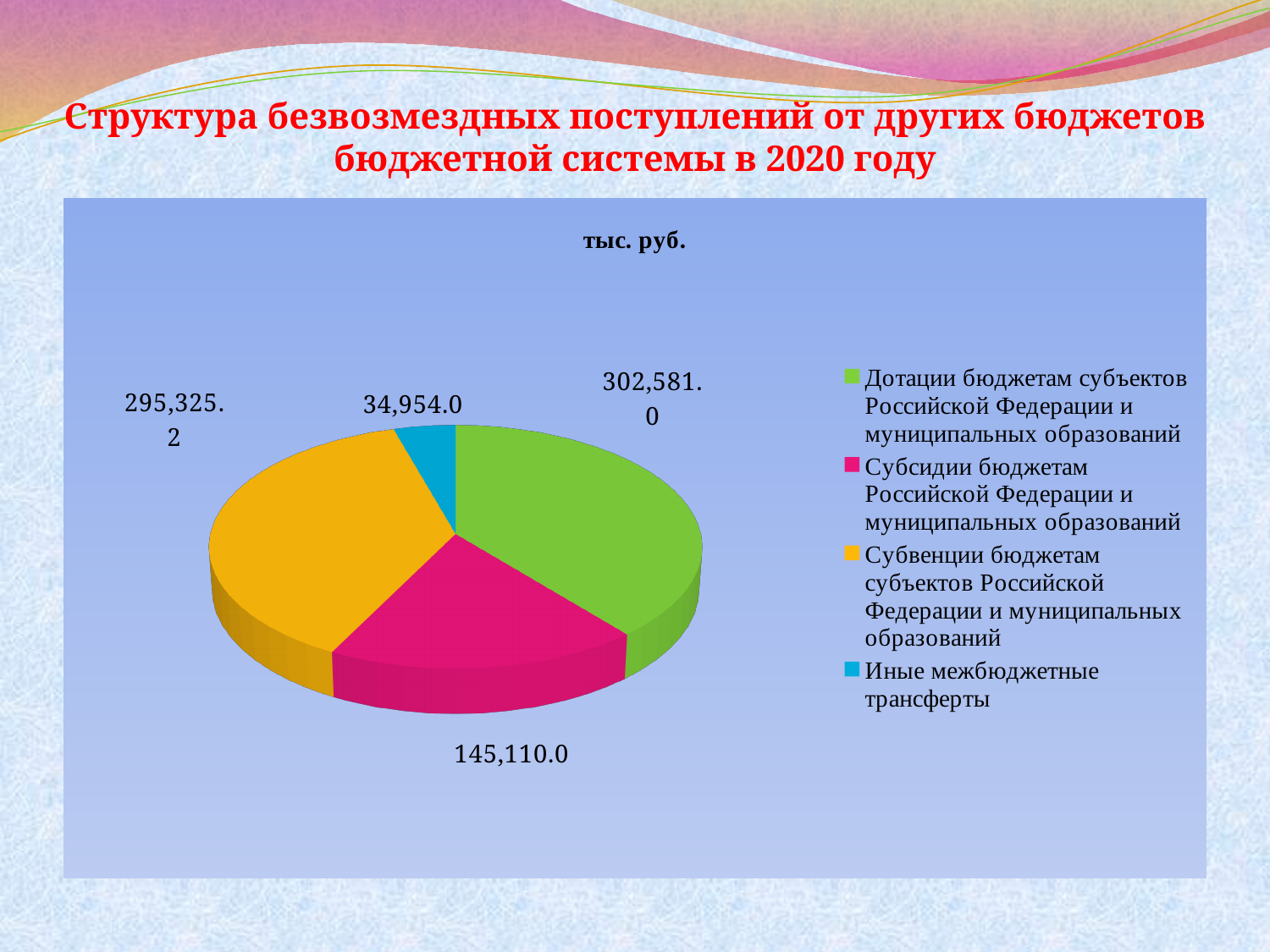
How many slices does the pie chart have? 4 What is the difference between the values for Дотации and Субвенции? 7,255.8 What is the value for Иные межбюджетные трансферты? 34,954.0 Which is larger: the value for Субсидии or the value for Иные межбюджетные трансферты? Субсидии What is the value for Дотации бюджетам субъектов Российской Федерации и муниципальных образований? 302,581.0 Which category has the smallest value? Иные межбюджетные трансферты What kind of chart is shown on the slide? Pie chart What is the difference between the values for Субсидии and Иные межбюджетные трансферты? 110,156.0 What is the value for Субсидии бюджетам Российской Федерации и муниципальных образований? 145,110.0 What is the value for Субвенции бюджетам субъектов Российской Федерации и муниципальных образований? 295,325.2 Which category has the largest value? Дотации бюджетам субъектов Российской Федерации и муниципальных образований What is the title shown above the chart? тыс. руб.